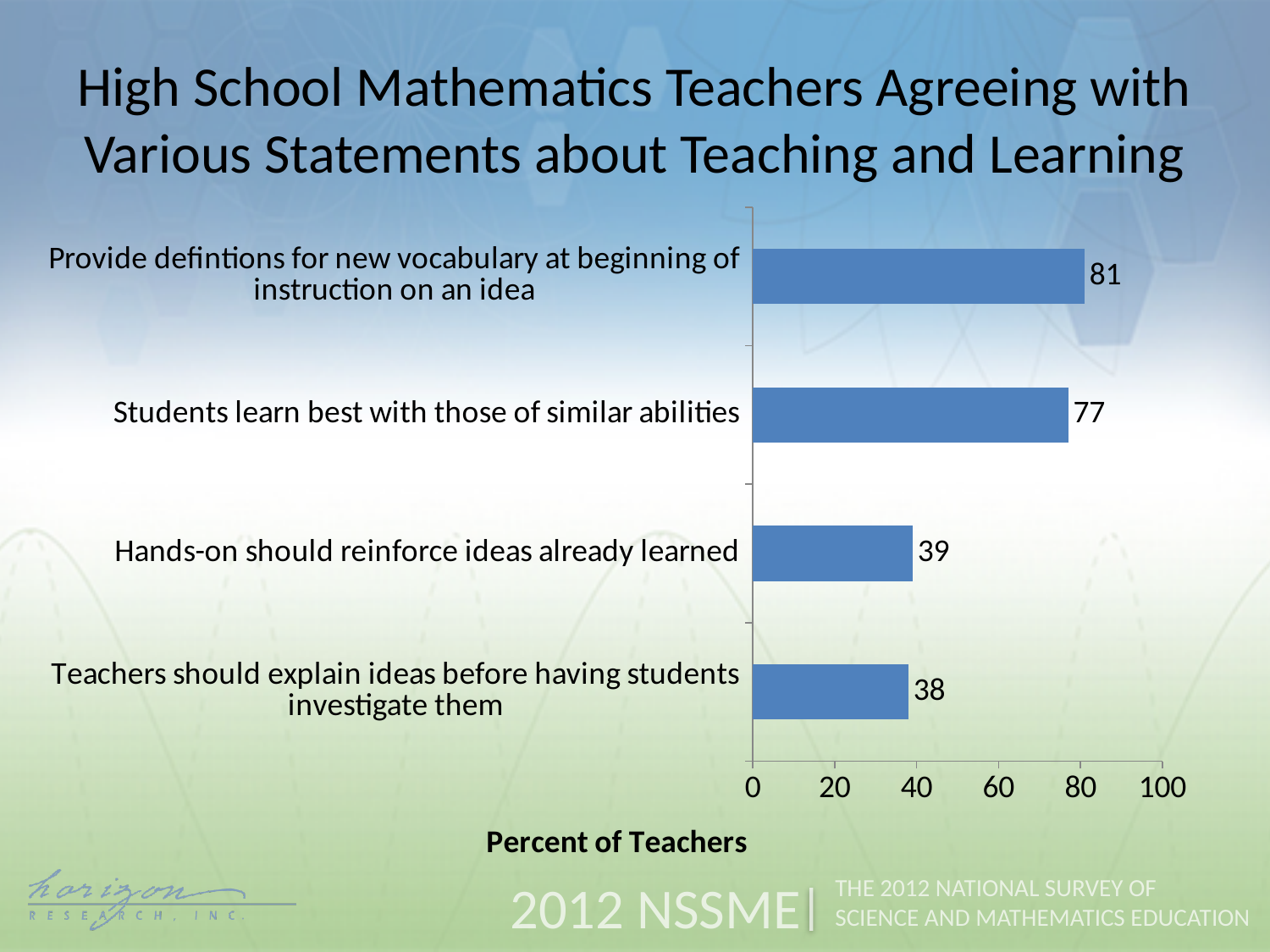
What percent of teachers agree that hands-on should reinforce ideas already learned? 39 What kind of chart is shown on the slide? Bar chart Is the value for 'Students learn best with those of similar abilities' greater or less than 60? greater Which statement has the lowest percent of teachers agreeing? Teachers should explain ideas before having students investigate them How many statements are shown in the chart? 4 Which has a higher percent of teachers agreeing: 'Students learn best with those of similar abilities' or 'Hands-on should reinforce ideas already learned'? Students learn best with those of similar abilities Which statement has the highest percent of teachers agreeing? Provide definitions for new vocabulary at beginning of instruction on an idea What percent of teachers agree that teachers should explain ideas before having students investigate them? 38 What is the label of the horizontal axis? Percent of Teachers What percent of teachers agree that students learn best with those of similar abilities? 77 What is the difference in percent of teachers between 'Provide definitions for new vocabulary at beginning of instruction on an idea' and 'Hands-on should reinforce ideas already learned'? 42 What percent of teachers agree that teachers should provide definitions for new vocabulary at the beginning of instruction on an idea? 81